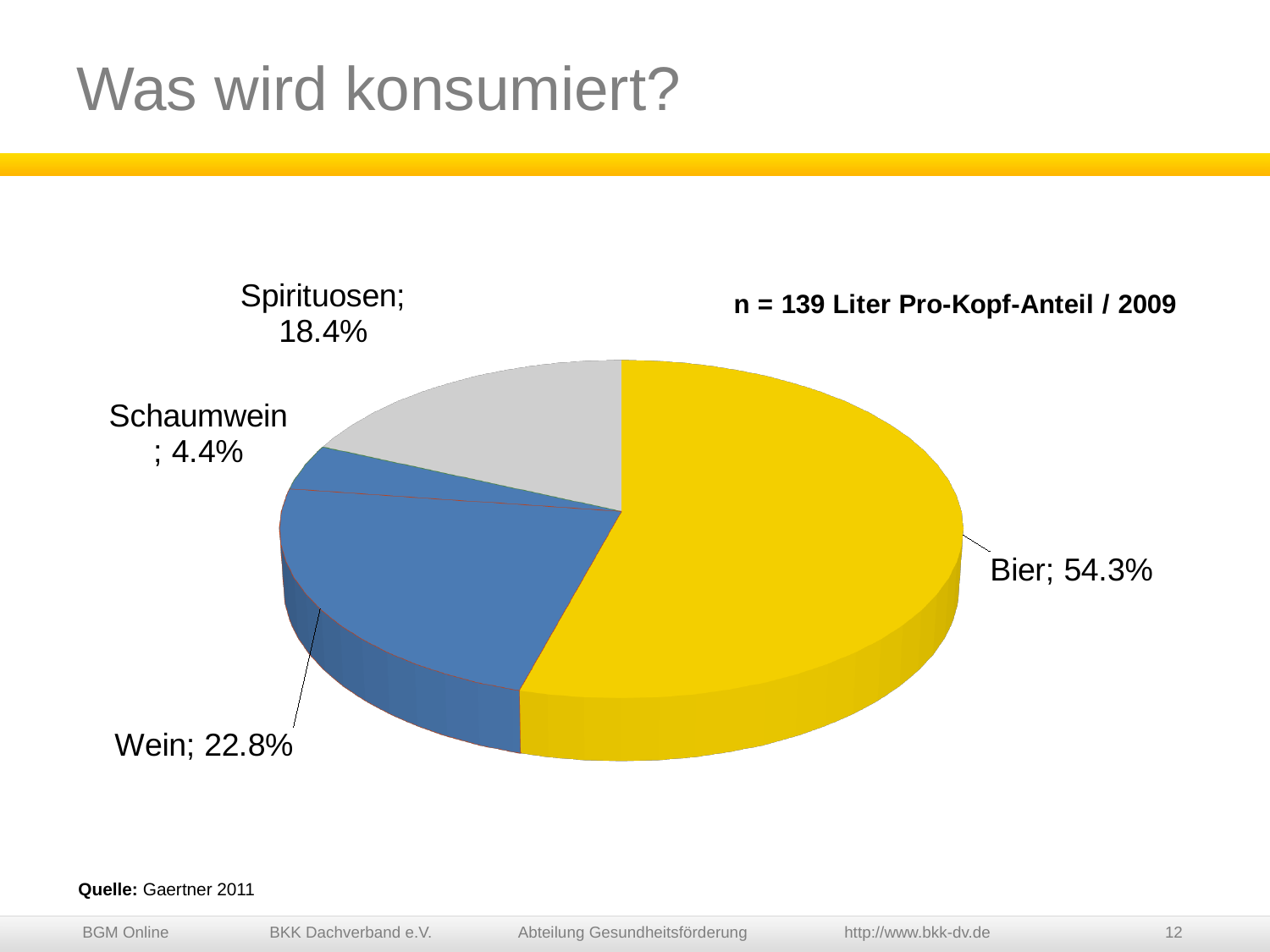
What is the difference in percentage points between the shares of Wein and Spirituosen? 4.4 What is the total per-capita amount in litres stated next to the chart? 139 Liter What share of the pie does Schaumwein have? 4.4% Which category has the smallest share of the pie? Schaumwein What share of the pie does Bier have? 54.3% What kind of chart is shown on the slide? Pie chart What is the difference in percentage points between the shares of Bier and Wein? 31.5 What share of the pie does Spirituosen have? 18.4% What share of the pie does Wein have? 22.8% Which category has the largest share of the pie? Bier How many categories are shown in the pie chart? 4 Which has a larger share, Wein or Spirituosen? Wein